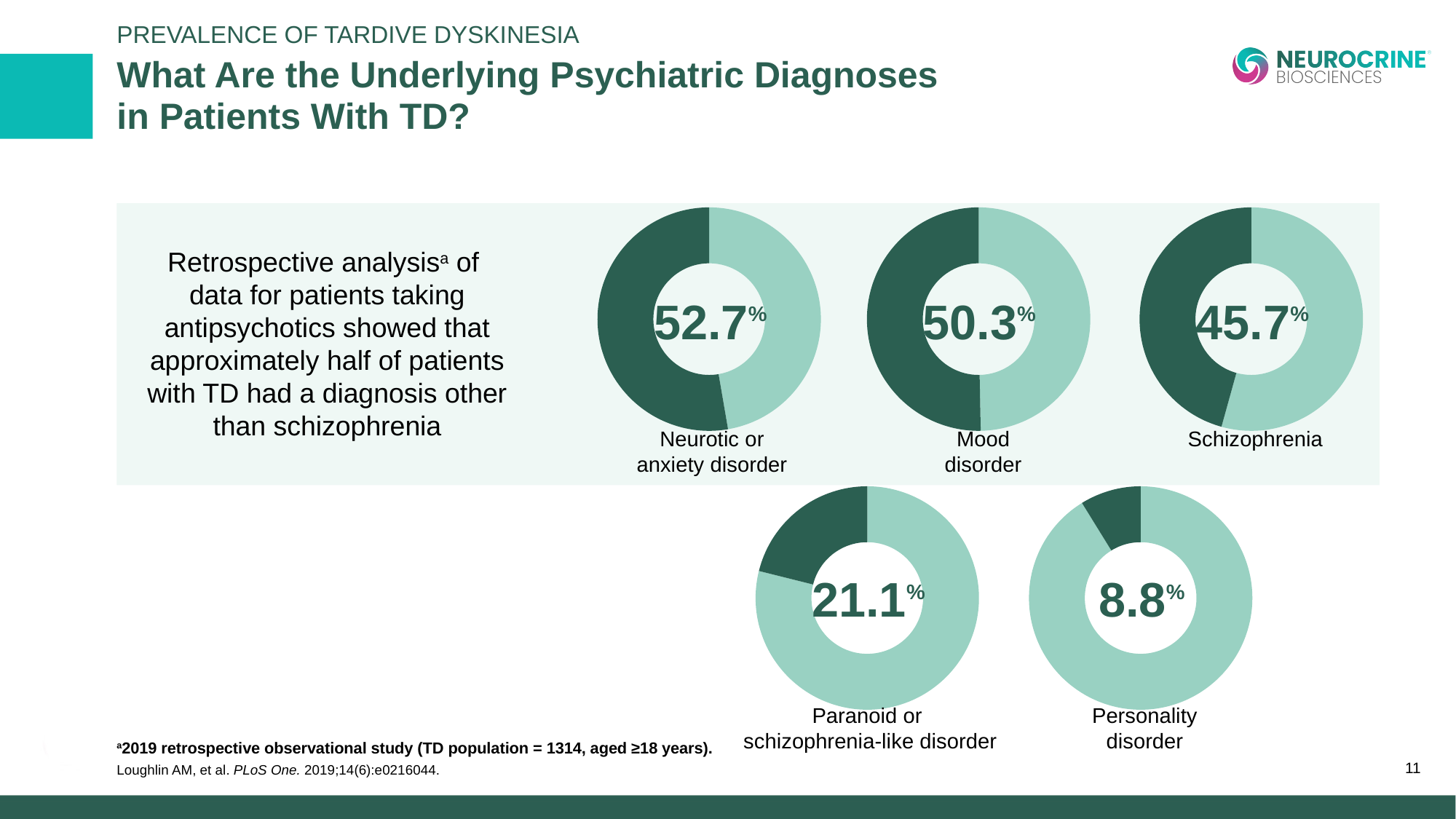
What percentage is shown in the donut chart labelled Personality disorder? 8.8% What is the difference between the percentage for Neurotic or anxiety disorder and the percentage for Mood disorder? 2.4% Which is larger, the percentage for Mood disorder or the percentage for Paranoid or schizophrenia-like disorder? Mood disorder What percentage is shown in the donut chart labelled Paranoid or schizophrenia-like disorder? 21.1% Which diagnosis has the lowest percentage across the donut charts on the slide? Personality disorder What kind of chart is used to show the percentage for each diagnosis on the slide? Donut chart What is the difference between the percentage for Schizophrenia and the percentage for Personality disorder? 36.9% What percentage is shown in the donut chart labelled Mood disorder? 50.3% What percentage is shown in the donut chart labelled Schizophrenia? 45.7% How many donut charts are shown on the slide? 5 Which diagnosis has the highest percentage across the donut charts on the slide? Neurotic or anxiety disorder What percentage is shown in the donut chart labelled Neurotic or anxiety disorder? 52.7%